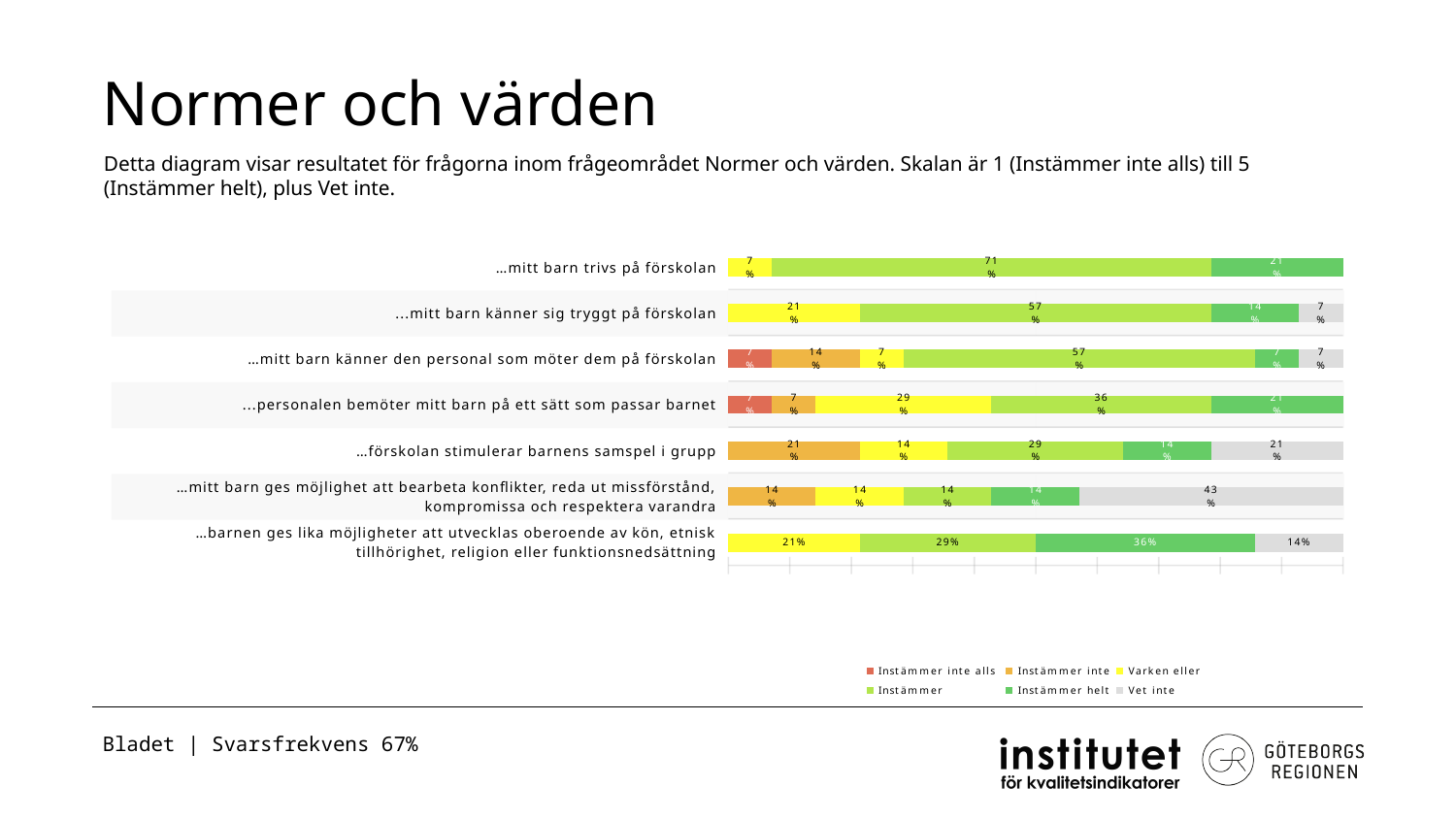
Which is larger: the 'Instämmer' value for '…mitt barn trivs på förskolan' or for '…mitt barn känner sig tryggt på förskolan'? …mitt barn trivs på förskolan Which statement has the highest 'Instämmer' value? …mitt barn trivs på förskolan Which statement has the highest 'Vet inte' value? …mitt barn ges möjlighet att bearbeta konflikter, reda ut missförstånd, kompromissa och respektera varandra How many series does the legend list? 6 How many statements (categories) are plotted in the chart? 7 What is the 'Instämmer' value for '…mitt barn känner sig tryggt på förskolan'? 57% What is the 'Instämmer' value for '…mitt barn trivs på förskolan'? 71% What is the difference between the 'Instämmer' value for '…mitt barn trivs på förskolan' and for '…mitt barn känner sig tryggt på förskolan'? 14 percentage points What kind of chart is shown on the slide? Stacked bar chart What is the 'Instämmer helt' value for '…barnen ges lika möjligheter att utvecklas oberoende av kön, etnisk tillhörighet, religion eller funktionsnedsättning'? 36% What is the 'Vet inte' value for '…mitt barn ges möjlighet att bearbeta konflikter, reda ut missförstånd, kompromissa och respektera varandra'? 43% What is the 'Varken eller' value for '…personalen bemöter mitt barn på ett sätt som passar barnet'? 29%